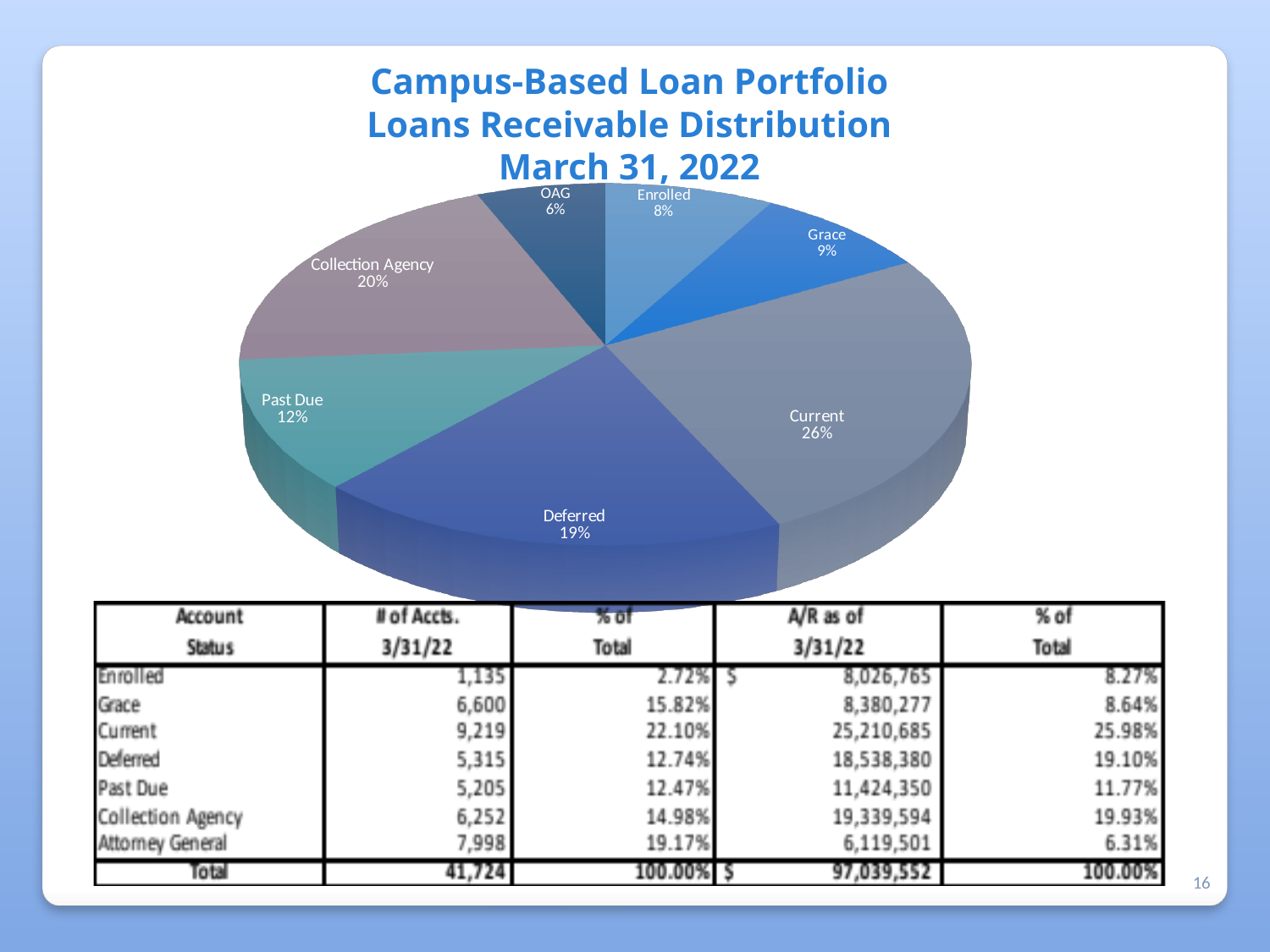
Which category has the smallest slice of the pie? OAG Which category has the largest slice of the pie? Current Which slice is larger, Collection Agency or Deferred? Collection Agency What percentage is shown for the Past Due slice? 12% How many slices does the pie chart have? 7 What kind of chart is shown on the slide? pie chart What date is given in the chart title? March 31, 2022 What share of the pie does the Current slice represent? 26% Which slice is larger, Enrolled or Grace? Grace What percentage is shown for the Collection Agency slice? 20% What is the difference in percentage points between the Deferred slice and the Grace slice? 10 What percentage is shown for the OAG slice? 6%